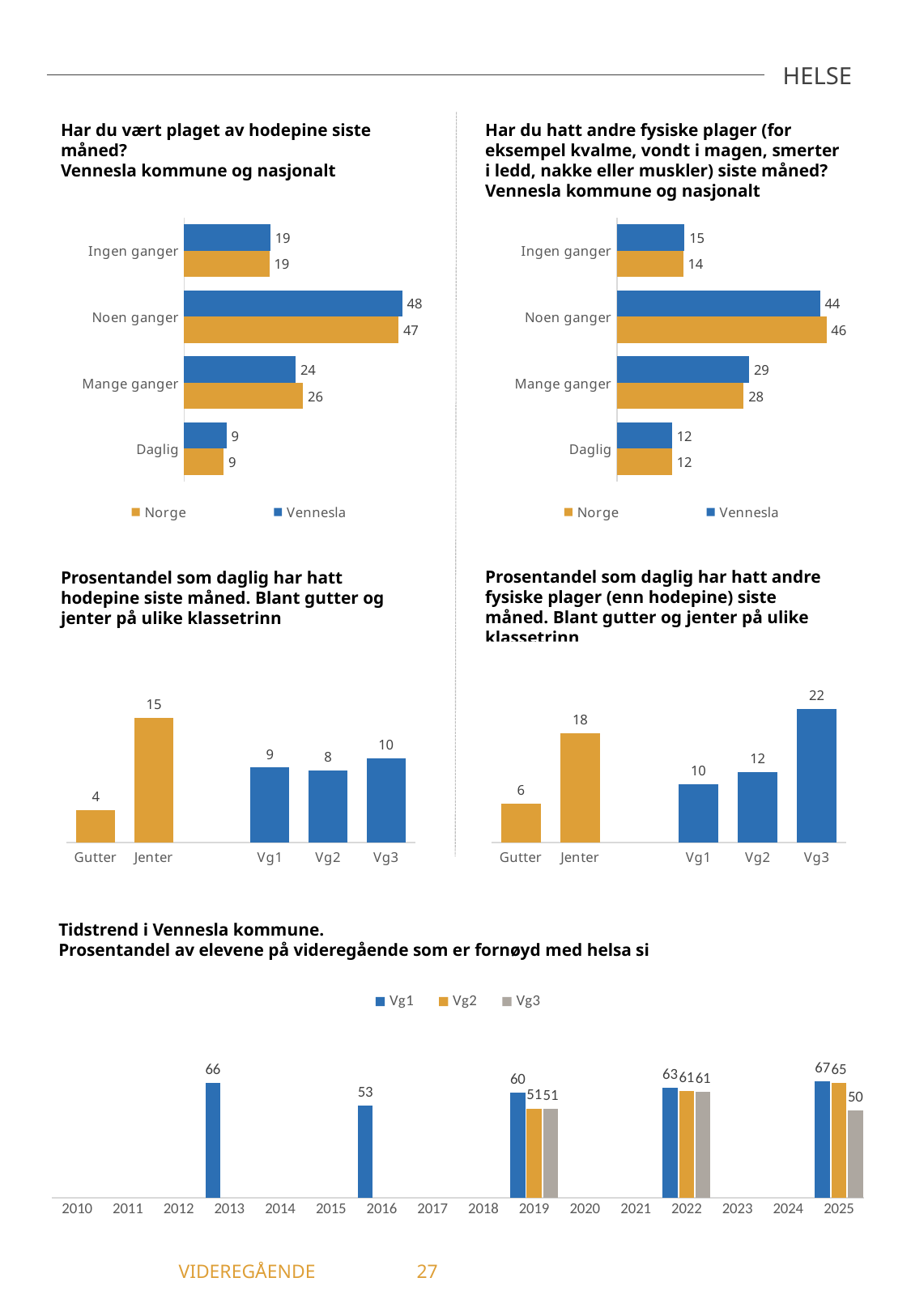
In the chart 'Prosentandel som daglig har hatt andre fysiske plager (enn hodepine) siste måned', what is the difference between Jenter and Gutter? 12 In the chart 'Tidstrend i Vennesla kommune', what is the value for Vg1 in 2016? 53 In the chart 'Prosentandel som daglig har hatt andre fysiske plager (enn hodepine) siste måned', which category has the highest value? Vg3 In the chart 'Prosentandel som daglig har hatt hodepine siste måned', what is the value for Jenter? 15 How many series does the legend list in the chart 'Har du hatt andre fysiske plager ... siste måned?'? 2 In the chart 'Har du vært plaget av hodepine siste måned?', what is the difference between Norge and Vennesla for 'Mange ganger'? 2 In the chart 'Har du hatt andre fysiske plager ... siste måned?', which category has the lowest value for Vennesla? Daglig What kind of chart is 'Tidstrend i Vennesla kommune'? Bar chart In the chart 'Tidstrend i Vennesla kommune', which is larger in 2025: Vg2 or Vg3? Vg2 In the chart 'Har du vært plaget av hodepine siste måned?', what is the value for Vennesla for 'Noen ganger'? 48 In the chart 'Prosentandel som daglig har hatt hodepine siste måned', which category has the lowest value? Gutter In the chart 'Har du hatt andre fysiske plager ... siste måned?', what is the value for Norge for 'Noen ganger'? 46